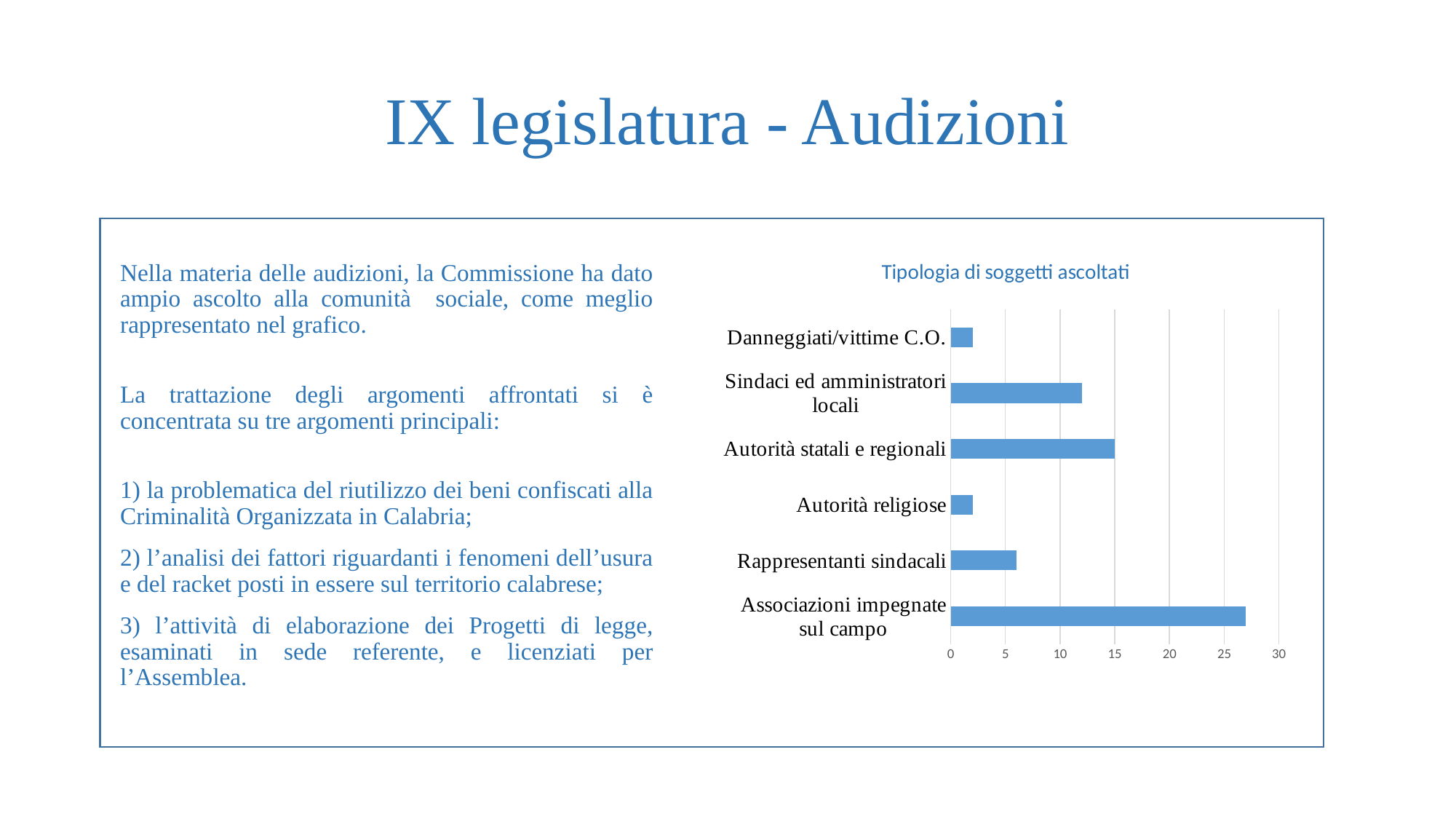
What is the value for Autorità statali e regionali? 15 Is the value for Associazioni impegnate sul campo greater or less than 25? greater Which is larger: the value for Autorità statali e regionali or the value for Associazioni impegnate sul campo? Associazioni impegnate sul campo Is the value for Rappresentanti sindacali greater or less than 10? less How many categories are shown in the chart? 6 Which category has the highest value? Associazioni impegnate sul campo Is the value for Sindaci ed amministratori locali greater or less than 10? greater What is the title of the chart? Tipologia di soggetti ascoltati What kind of chart is shown on the slide? bar chart Which is larger: the value for Sindaci ed amministratori locali or the value for Rappresentanti sindacali? Sindaci ed amministratori locali